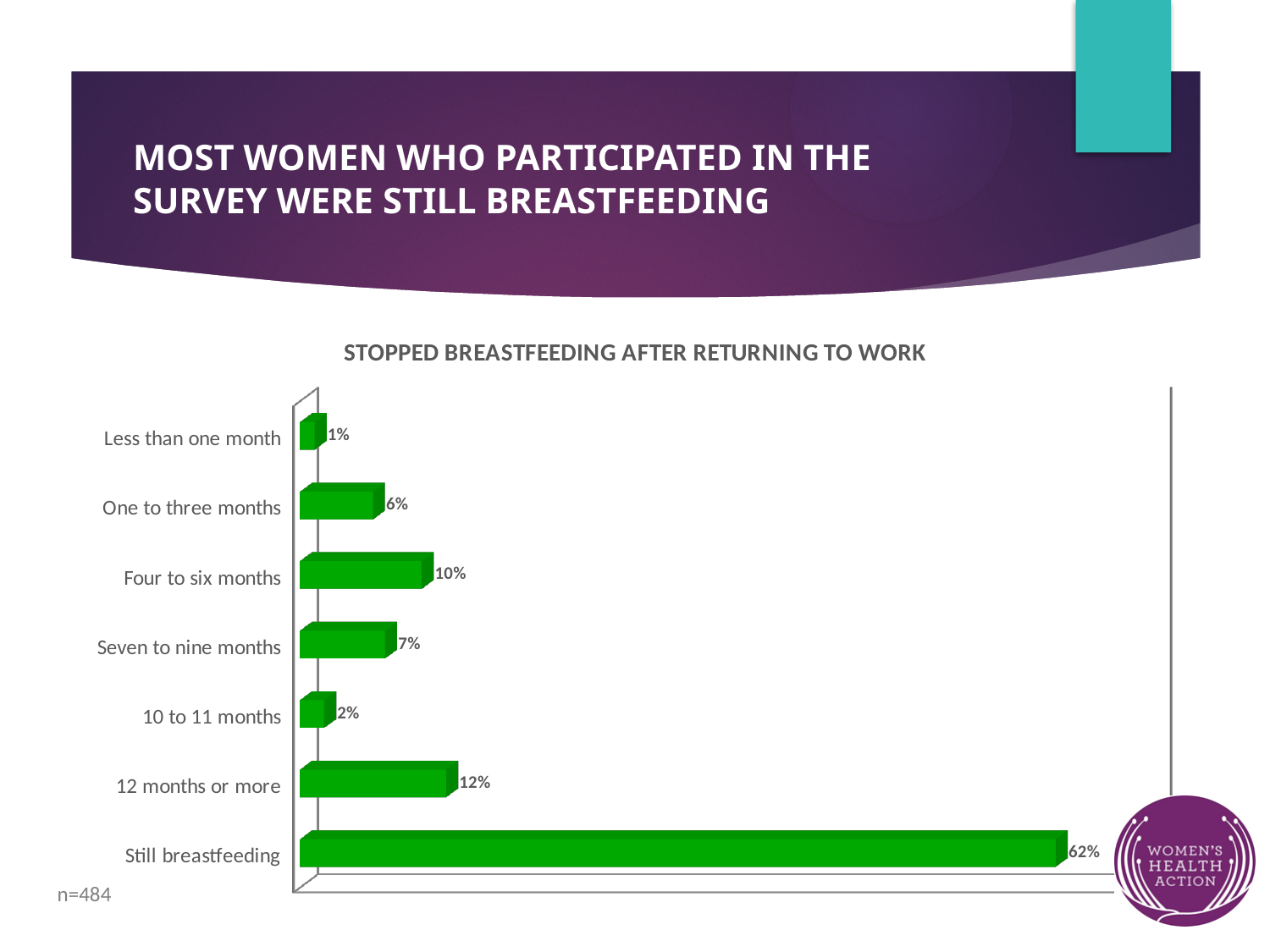
What kind of chart is shown on the slide? Bar chart What is the difference between 'Still breastfeeding' and '12 months or more'? 50% What percentage of women were still breastfeeding? 62% Which is larger, 'One to three months' or 'Seven to nine months'? Seven to nine months What is the title of the chart? STOPPED BREASTFEEDING AFTER RETURNING TO WORK What is the difference between 'Four to six months' and 'Seven to nine months'? 3% Which category has the highest value? Still breastfeeding Which category has the lowest value? Less than one month What is the value for 'Four to six months'? 10% What is the value for 'Less than one month'? 1% What is the value for '12 months or more'? 12% How many categories are shown in the chart? 7